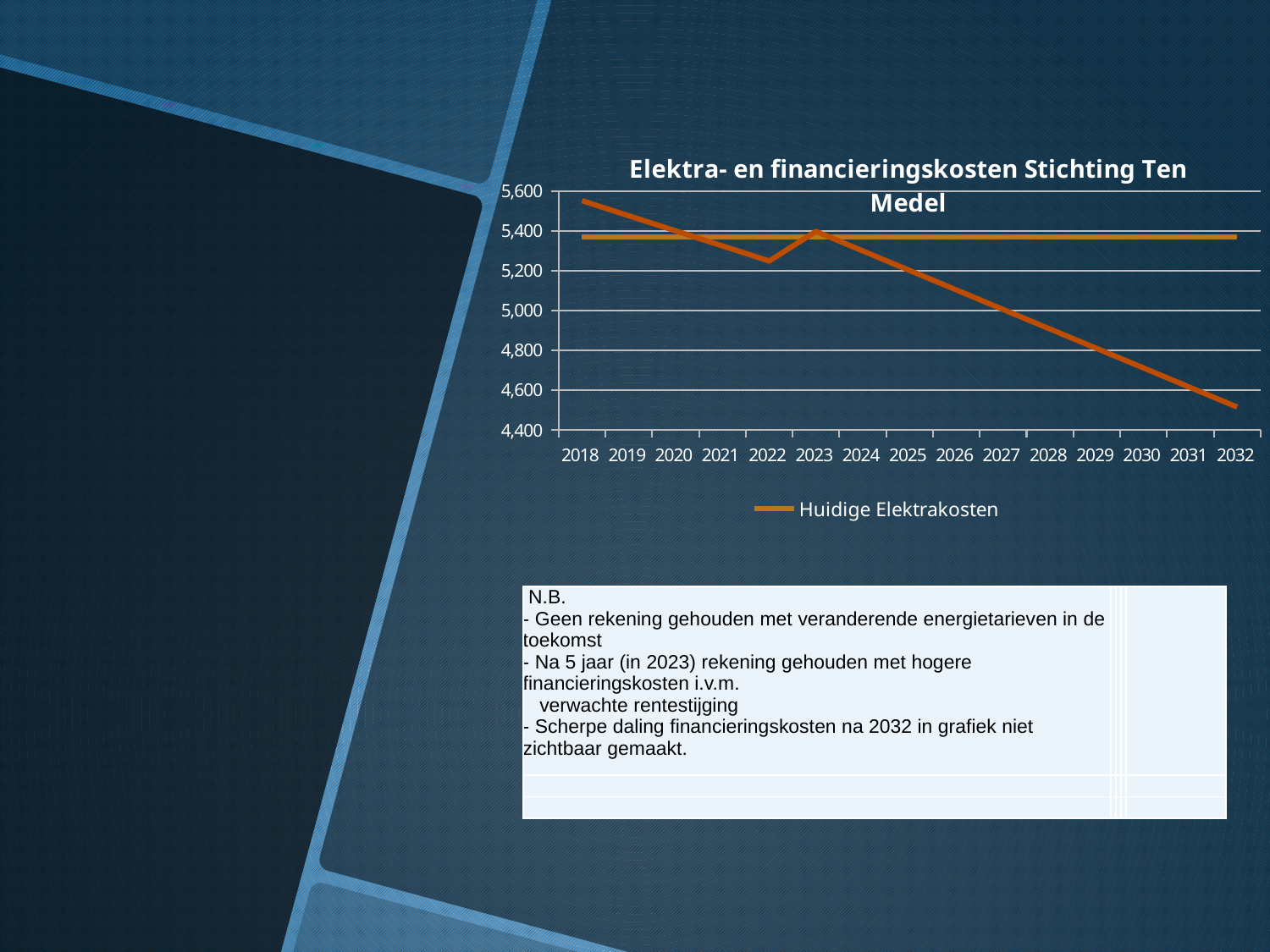
Is the value of Huidige Elektrakosten in 2018 greater or less than 5,200? greater How many series does the chart's legend list? 1 What is the title of the chart? Elektra- en financieringskosten Stichting Ten Medel Does the Huidige Elektrakosten line rise, fall or stay flat from 2018 to 2032? stays flat In 2032, which line is higher: Huidige Elektrakosten or the declining line not named in the legend? Huidige Elektrakosten What kind of chart is shown on the slide? line chart Does the line that is not named in the legend rise or fall overall from 2018 to 2032? fall Is the value of the declining line (the one not named in the legend) in 2032 greater or less than 4,600? less Is the value of the declining line (the one not named in the legend) in 2018 greater or less than 5,400? greater How many years are shown on the x axis of the chart? 15 What is the name of the series listed in the legend? Huidige Elektrakosten